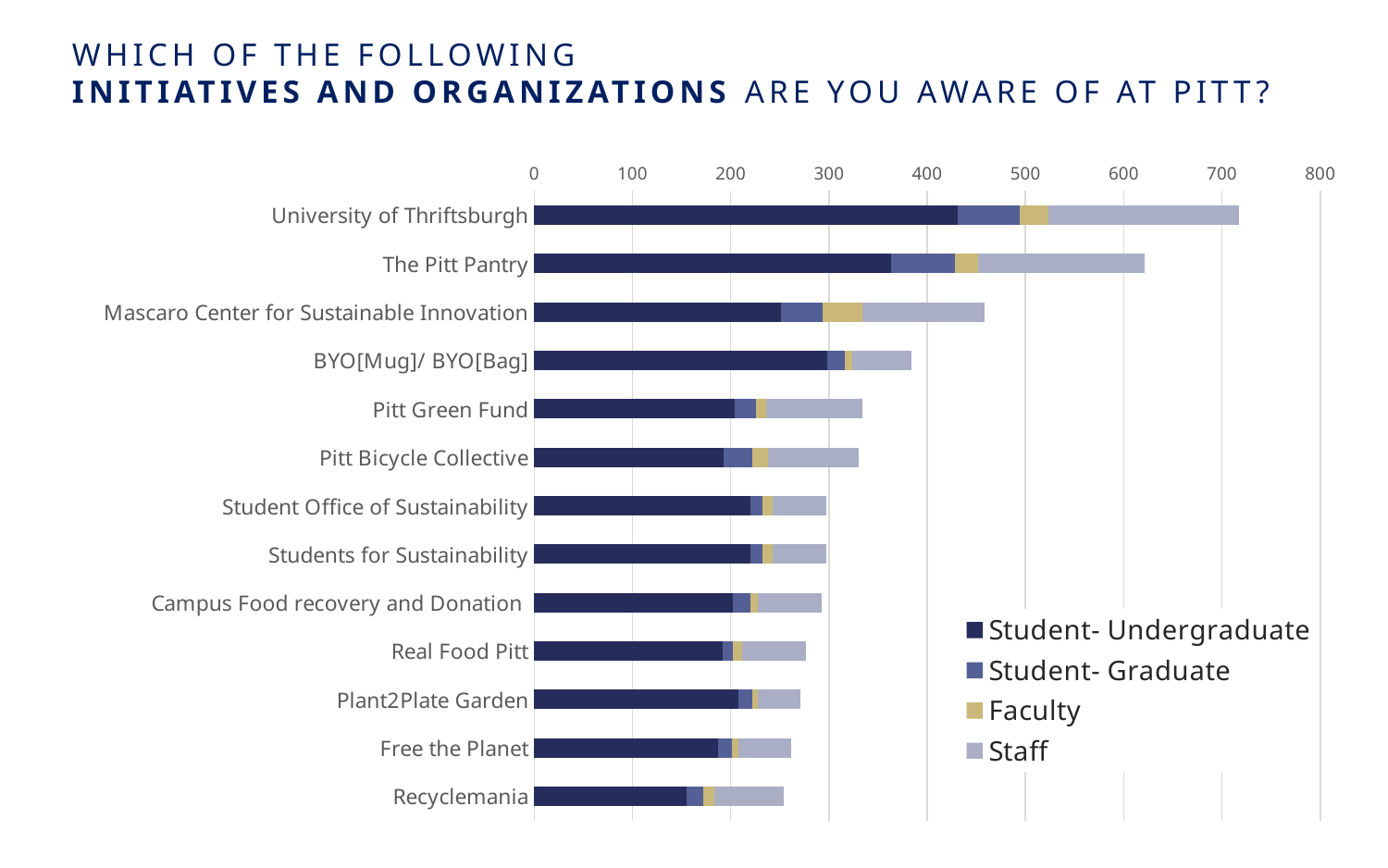
Which has a larger total bar, BYO[Mug]/ BYO[Bag] or Pitt Green Fund? BYO[Mug]/ BYO[Bag] Which initiative or organization has the shortest total bar? Recyclemania Is the total value for BYO[Mug]/ BYO[Bag] greater or less than 400? less Which has a larger total bar, The Pitt Pantry or Mascaro Center for Sustainable Innovation? The Pitt Pantry Which series is shown in the darkest blue colour in the legend? Student- Undergraduate Is the total value for University of Thriftsburgh greater or less than 700? greater Is the total value for Mascaro Center for Sustainable Innovation greater or less than 500? less How many initiatives and organizations are listed on the chart? 13 Which initiative or organization has the longest total bar? University of Thriftsburgh How many series does the legend list? 4 What kind of chart is shown on the slide? Stacked bar chart